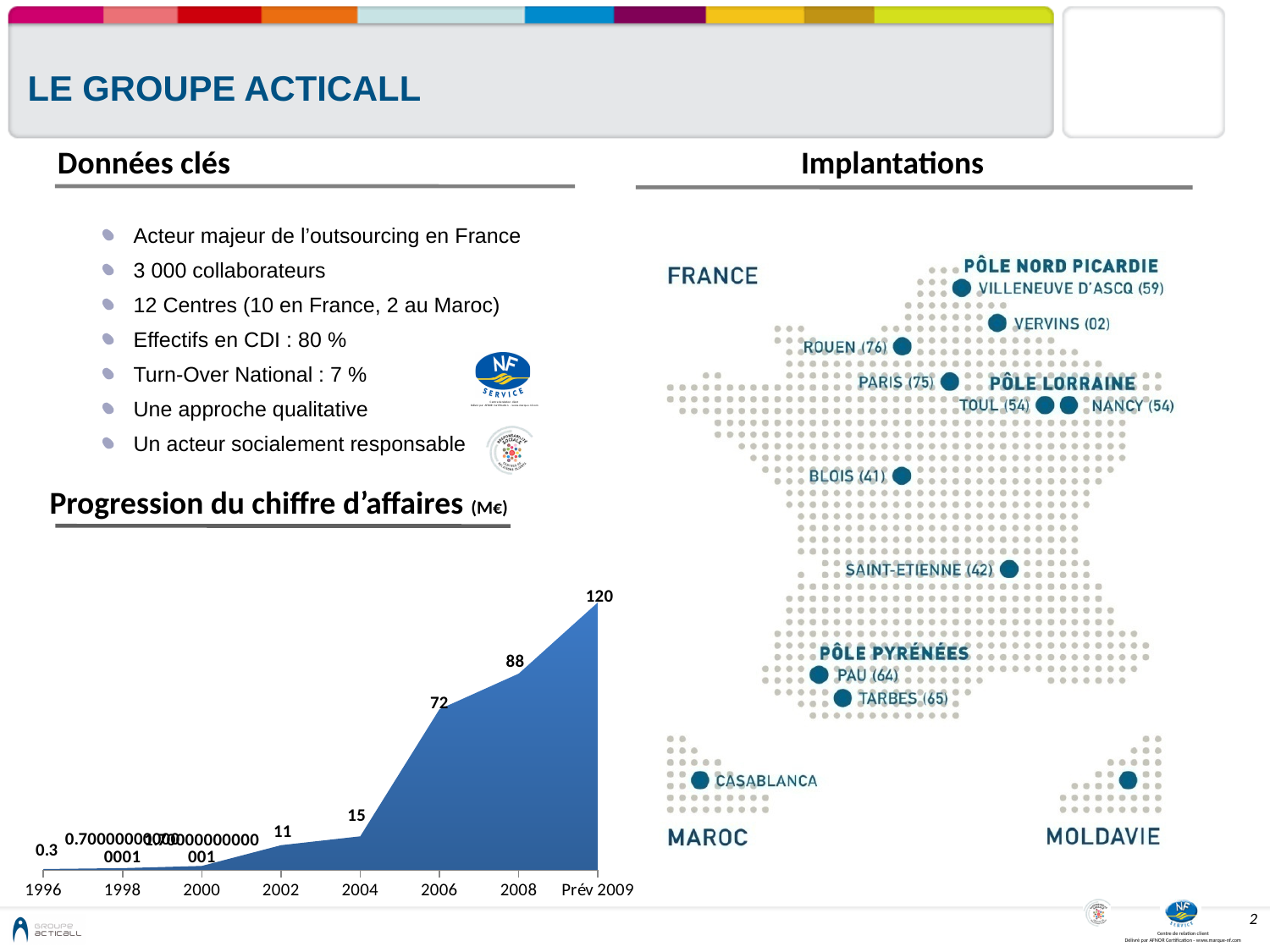
How many points are plotted along the x axis of the 'Progression du chiffre d'affaires' chart? 8 What is the value for 2008 in the 'Progression du chiffre d'affaires' chart? 88 What is the value for 1996 in the 'Progression du chiffre d'affaires' chart? 0.3 What is the value for 2004 in the 'Progression du chiffre d'affaires' chart? 15 What is the value for 2002 in the 'Progression du chiffre d'affaires' chart? 11 Which year has the highest value in the 'Progression du chiffre d'affaires' chart? Prév 2009 Which is larger in the 'Progression du chiffre d'affaires' chart, the value for 2006 or the value for 2004? 2006 What is the value for Prév 2009 in the 'Progression du chiffre d'affaires' chart? 120 What kind of chart is 'Progression du chiffre d'affaires'? Area chart What is the difference between the values for Prév 2009 and 2008 in the 'Progression du chiffre d'affaires' chart? 32 What is the value for 2006 in the 'Progression du chiffre d'affaires' chart? 72 Which year has the lowest value in the 'Progression du chiffre d'affaires' chart? 1996